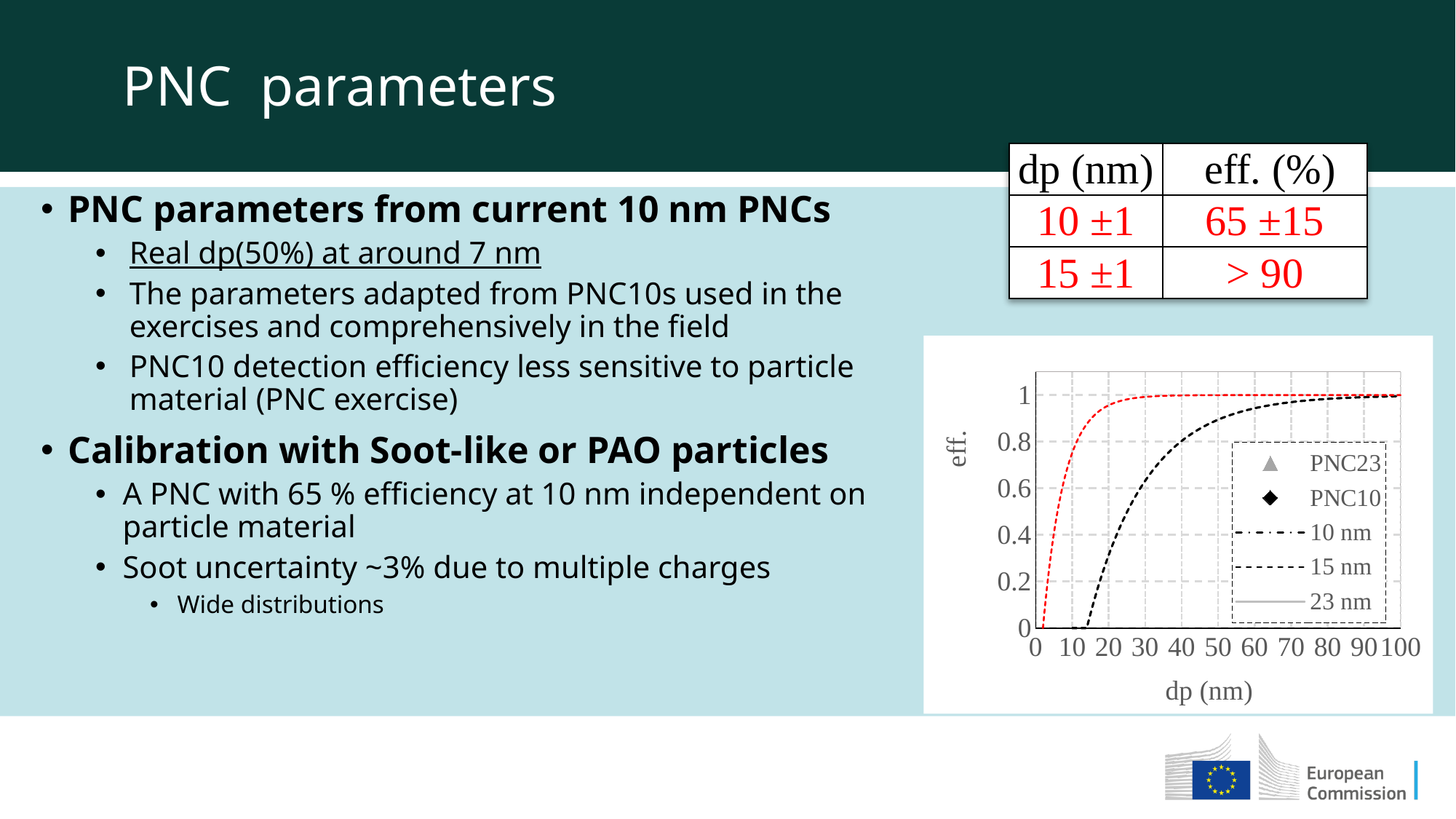
What is the highest value shown on the chart's x axis? 100 What kind of chart is shown on the slide? line chart Is the value of the black curve at dp = 10 nm greater or less than 0.2? less At dp = 20 nm, which curve has the higher efficiency, the red curve or the black curve? the red curve Do the curves in the chart rise or fall as dp increases? rise Is the value of the black curve at dp = 30 nm greater or less than 0.8? less What is the label of the chart's x axis? dp (nm) Is the value of the red curve at dp = 20 nm greater or less than 0.8? greater How many entries does the chart's legend list? 5 What are the entries listed in the chart's legend? PNC23, PNC10, 10 nm, 15 nm, 23 nm